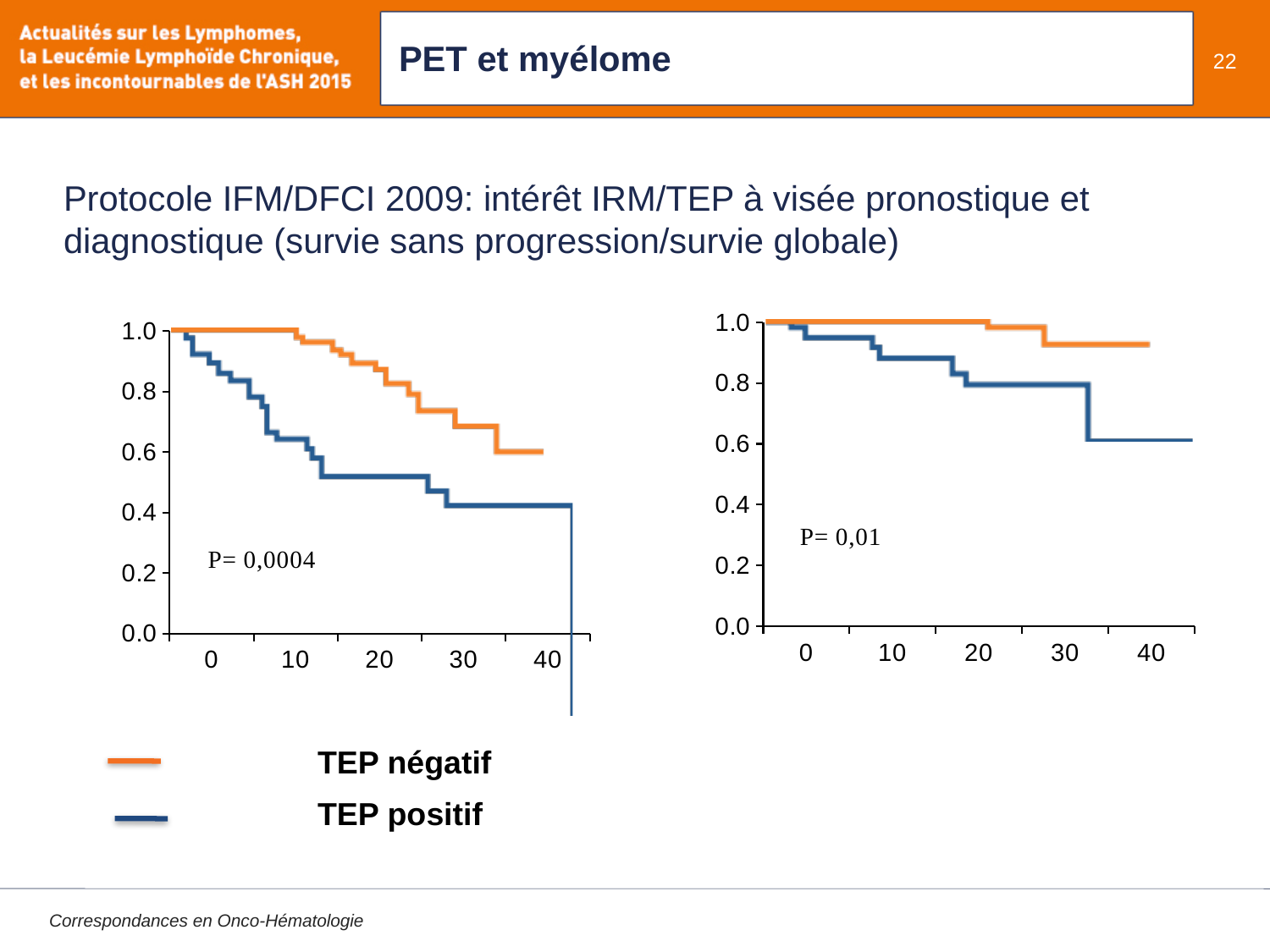
In the left chart, is the value for TEP positif at 30 on the x axis greater or less than 0.6? less What P value is printed on the right chart? P= 0,01 How many series does the legend list? 2 In the right chart, which curve is higher at 40 on the x axis, TEP négatif or TEP positif? TEP négatif In the right chart, is the value for TEP positif at 40 on the x axis greater or less than 0.8? less In the left chart, is the value for TEP négatif at 20 on the x axis greater or less than 0.6? greater What P value is printed on the left chart? P= 0,0004 In the left chart, do the curves rise or fall along the x axis? fall Which colour represents TEP positif in the legend? blue In the left chart, which curve is higher at 30 on the x axis, TEP négatif or TEP positif? TEP négatif What kind of chart is the left chart on the slide? line chart